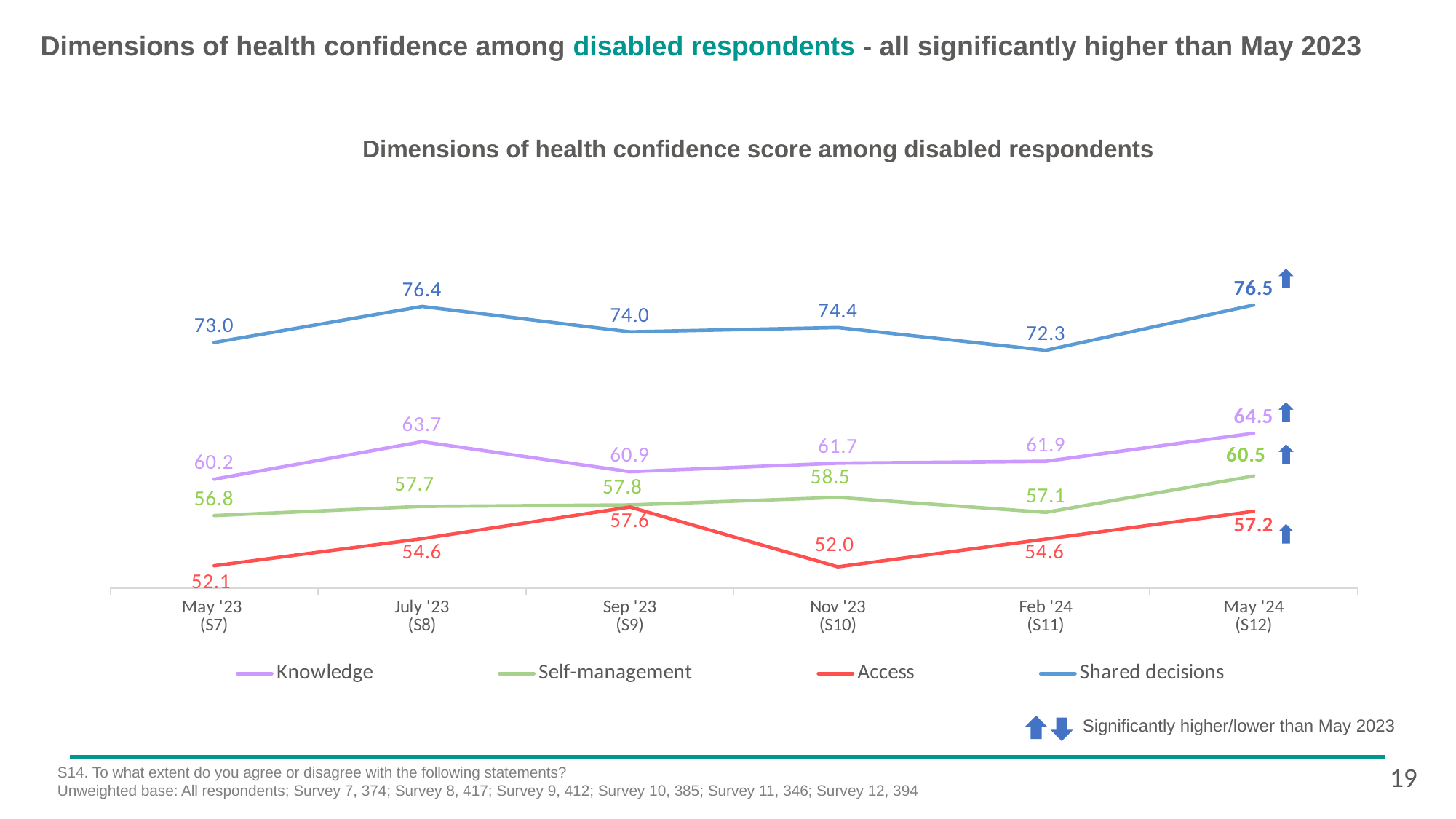
How many survey waves are shown on the x axis? 6 Which is larger in Sep '23 (S9): the Self-management score or the Access score? Self-management Which series is shown in red? Access What type of chart is shown? Line chart What is the Access score in Nov '23 (S10)? 52.0 What is the Self-management score in Feb '24 (S11)? 57.1 In which survey wave is the Knowledge score highest? May '24 (S12) In which survey wave is the Shared decisions score lowest? Feb '24 (S11) What is the Knowledge score in July '23 (S8)? 63.7 What is the Shared decisions score in May '24 (S12)? 76.5 How many series does the legend list? 4 What is the difference between the Access score in May '24 (S12) and May '23 (S7)? 5.1